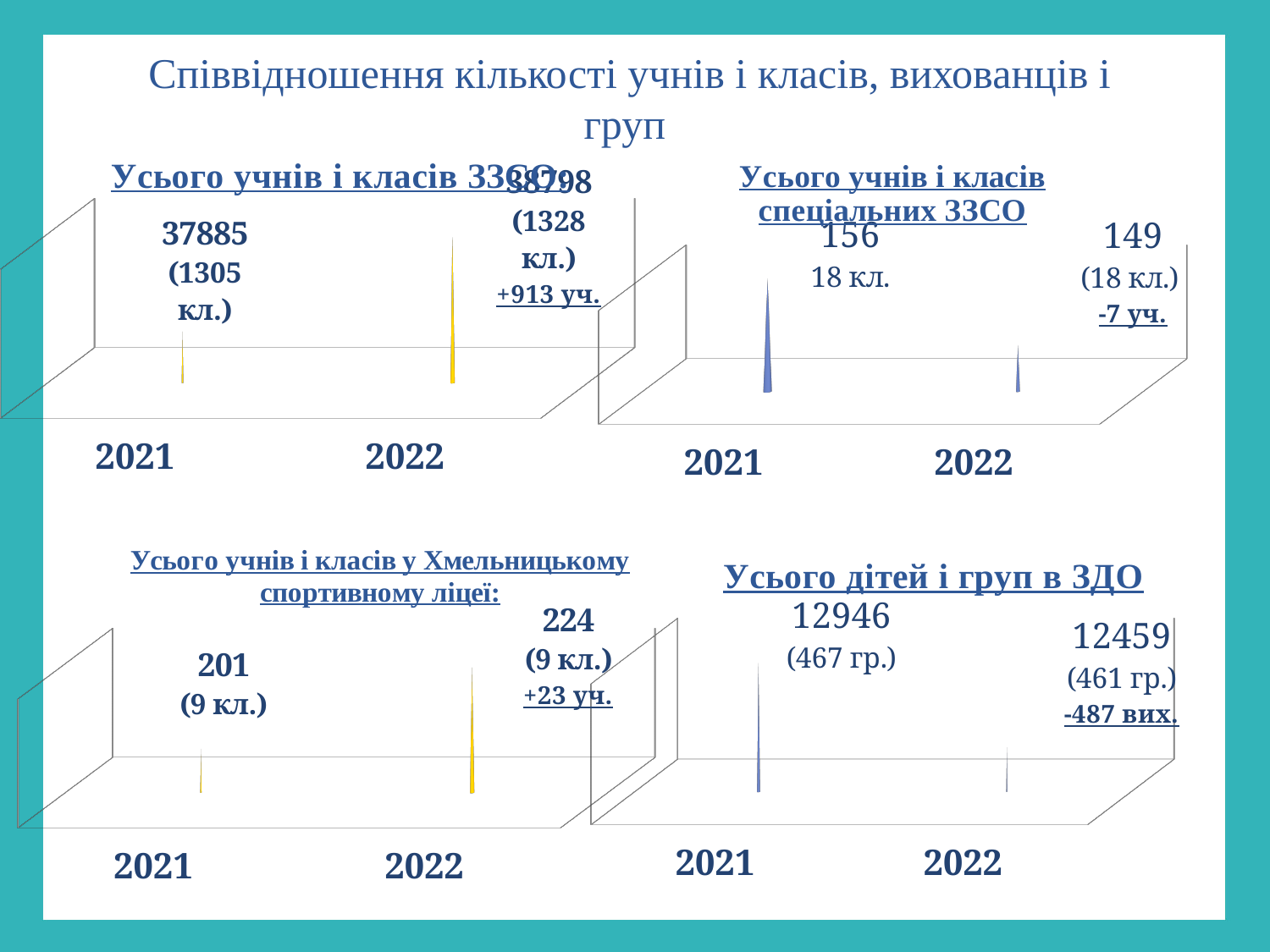
In the chart 'Усього дітей і груп в ЗДО' (bottom right), what is the value for 2021? 12946 In the chart 'Усього дітей і груп в ЗДО' (bottom right), do the values rise or fall from 2021 to 2022? fall In the chart 'Усього учнів і класів у Хмельницькому спортивному ліцеї' (bottom left), what is the value for 2022? 224 In the chart 'Усього учнів і класів спеціальних ЗЗСО' (top right), what is the value for 2022? 149 In the chart 'Усього учнів і класів спеціальних ЗЗСО' (top right), which year has the higher value? 2021 How many charts are on the slide, and what kind of chart are they? 4 bar charts In the chart 'Усього учнів і класів ЗЗСО' (top left), what is the value for 2021? 37885 In the chart 'Усього учнів і класів спеціальних ЗЗСО' (top right), what is the value for 2021? 156 In the chart 'Усього учнів і класів ЗЗСО' (top left), how many classes are shown for 2022? 1328 кл. In the chart 'Усього учнів і класів ЗЗСО' (top left), by how much did the number of students change from 2021 to 2022, as labelled on the slide? +913 уч. In the chart 'Усього учнів і класів у Хмельницькому спортивному ліцеї' (bottom left), what is the difference between the 2022 and 2021 values? 23 In the chart 'Усього дітей і груп в ЗДО' (bottom right), how many groups are shown for 2022? 461 гр.